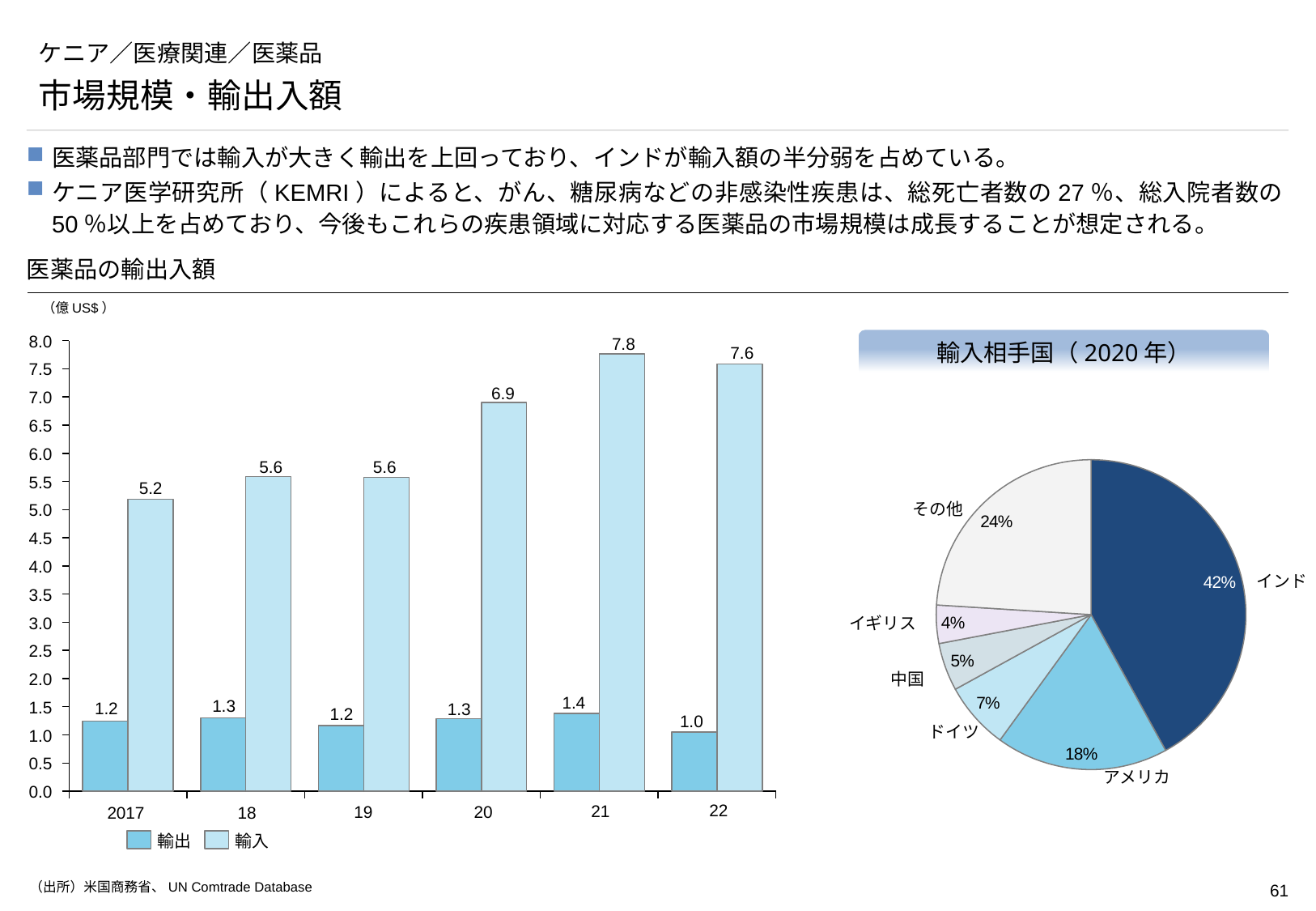
「医薬品の輸出入額」のグラフで、2020年の輸入の値はいくらですか？ 6.9 「輸入相手国（2020年）」の円グラフで、アメリカの割合はいくらですか？ 18% 「医薬品の輸出入額」のグラフの凡例には、いくつの系列がありますか？ 2 「医薬品の輸出入額」のグラフで、輸入が最も多い年はどれですか？ 21 「医薬品の輸出入額」のグラフで、2021年の輸入と輸出の差はいくらですか？ 6.4 「医薬品の輸出入額」のグラフで、2017年から2021年にかけて輸入は増加していますか、減少していますか？ 増加 「医薬品の輸出入額」のグラフで、輸出が最も少ない年はどれですか？ 22 「医薬品の輸出入額」のグラフで、2017年の輸入と2018年の輸入ではどちらが大きいですか？ 2018年の輸入 「輸入相手国（2020年）」の円グラフには、いくつの区分がありますか？ 6 「医薬品の輸出入額」のグラフで、2022年の輸出の値はいくらですか？ 1.0 「医薬品の輸出入額」のグラフは、どの種類のグラフですか？ 棒グラフ 「輸入相手国（2020年）」の円グラフで、最も割合が大きい国はどこですか？ インド